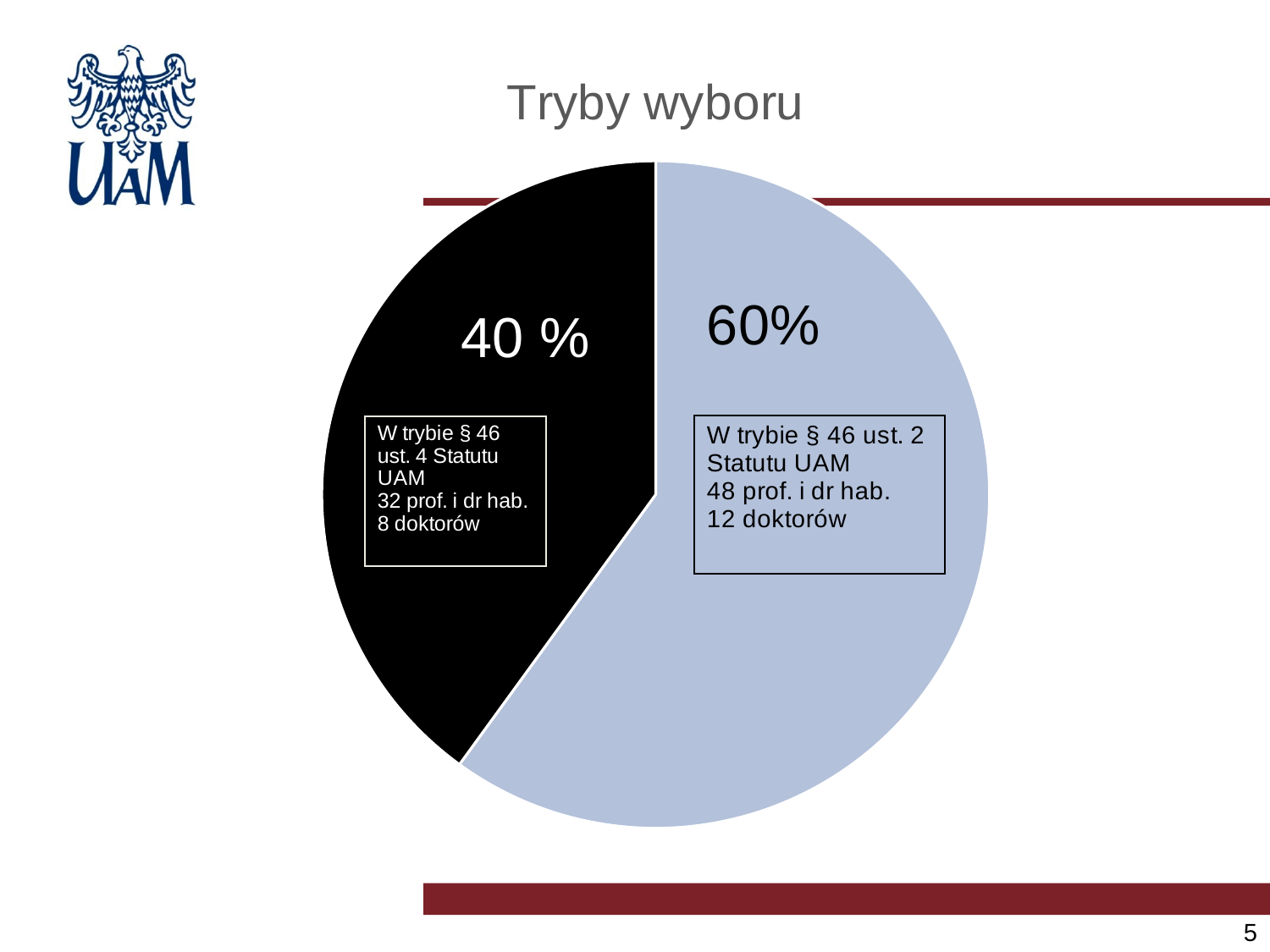
Which slice is the smallest in the pie chart? W trybie § 46 ust. 4 Statutu UAM (40 %) How many slices does the pie chart have? 2 What share of the pie is labelled for the mode "W trybie § 46 ust. 4 Statutu UAM"? 40 % What share of the pie is labelled for the mode "W trybie § 46 ust. 2 Statutu UAM"? 60% How many "prof. i dr hab." are listed for the slice "W trybie § 46 ust. 2 Statutu UAM"? 48 What colour is the slice labelled 40 %? black How many "doktorów" are listed for the slice "W trybie § 46 ust. 4 Statutu UAM"? 8 What is the difference in percentage points between the 60% slice and the 40 % slice? 20 percentage points What type of chart is shown on the slide? pie chart What is the title of the chart? Tryby wyboru Which slice is the largest in the pie chart? W trybie § 46 ust. 2 Statutu UAM (60%) Which slice has more "doktorów": "W trybie § 46 ust. 2" or "W trybie § 46 ust. 4"? W trybie § 46 ust. 2 (12 doktorów)